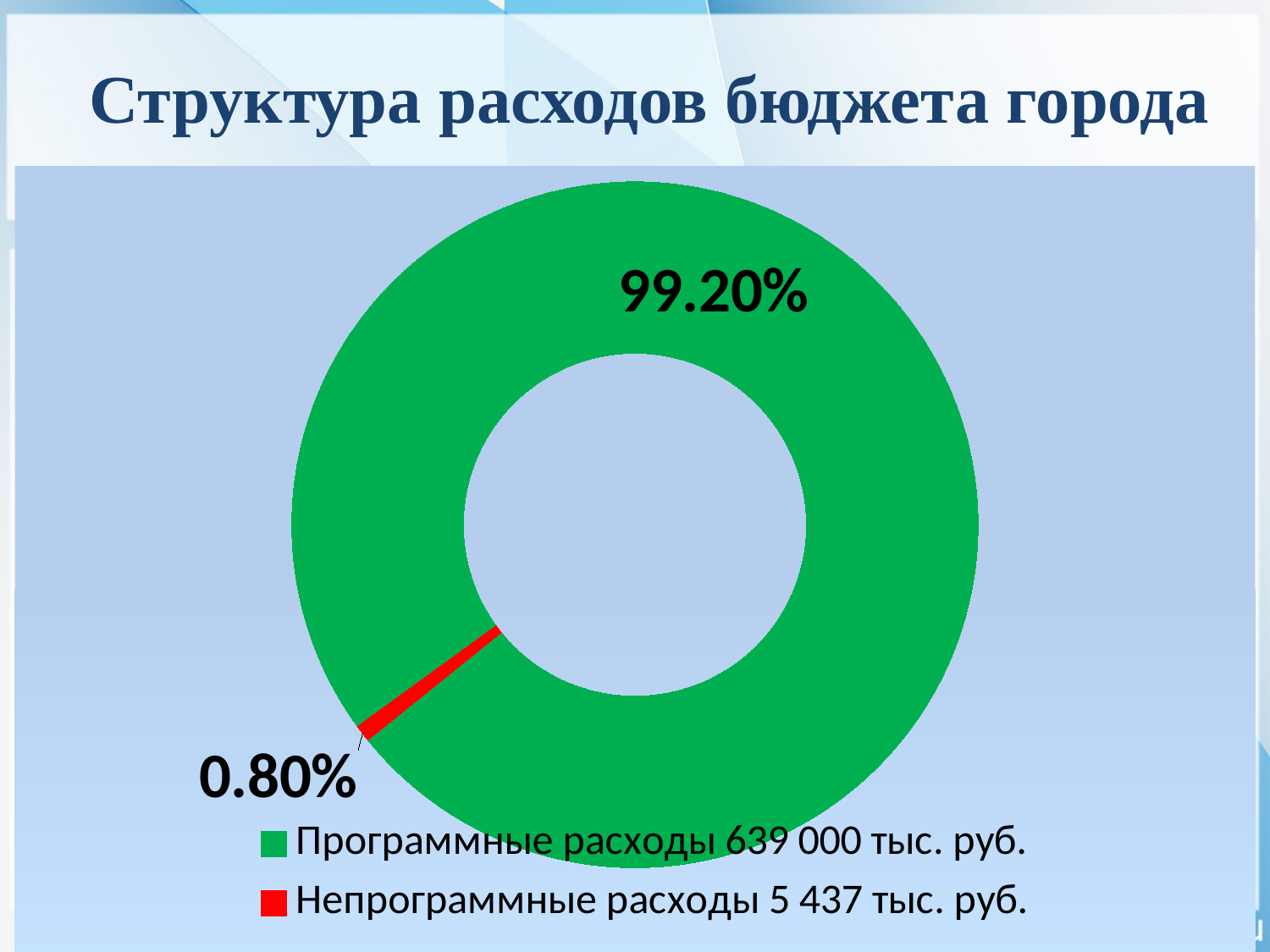
What is the title of the slide? Структура расходов бюджета города What colour represents Непрограммные расходы in the legend? Red What is the difference in percentage points between the two slices? 98.40% Which is larger: Программные расходы or Непрограммные расходы? Программные расходы Which category has the smallest share of the chart? Непрограммные расходы Which category has the largest share of the chart? Программные расходы How many categories are shown in the chart? 2 What share of the chart does the red slice (Непрограммные расходы) represent? 0.80% According to the legend, what amount is given for Непрограммные расходы? 5 437 тыс. руб. What kind of chart is shown on the slide? Doughnut (pie) chart According to the legend, what amount is given for Программные расходы? 639 000 тыс. руб. What share of the chart does the green slice (Программные расходы) represent? 99.20%